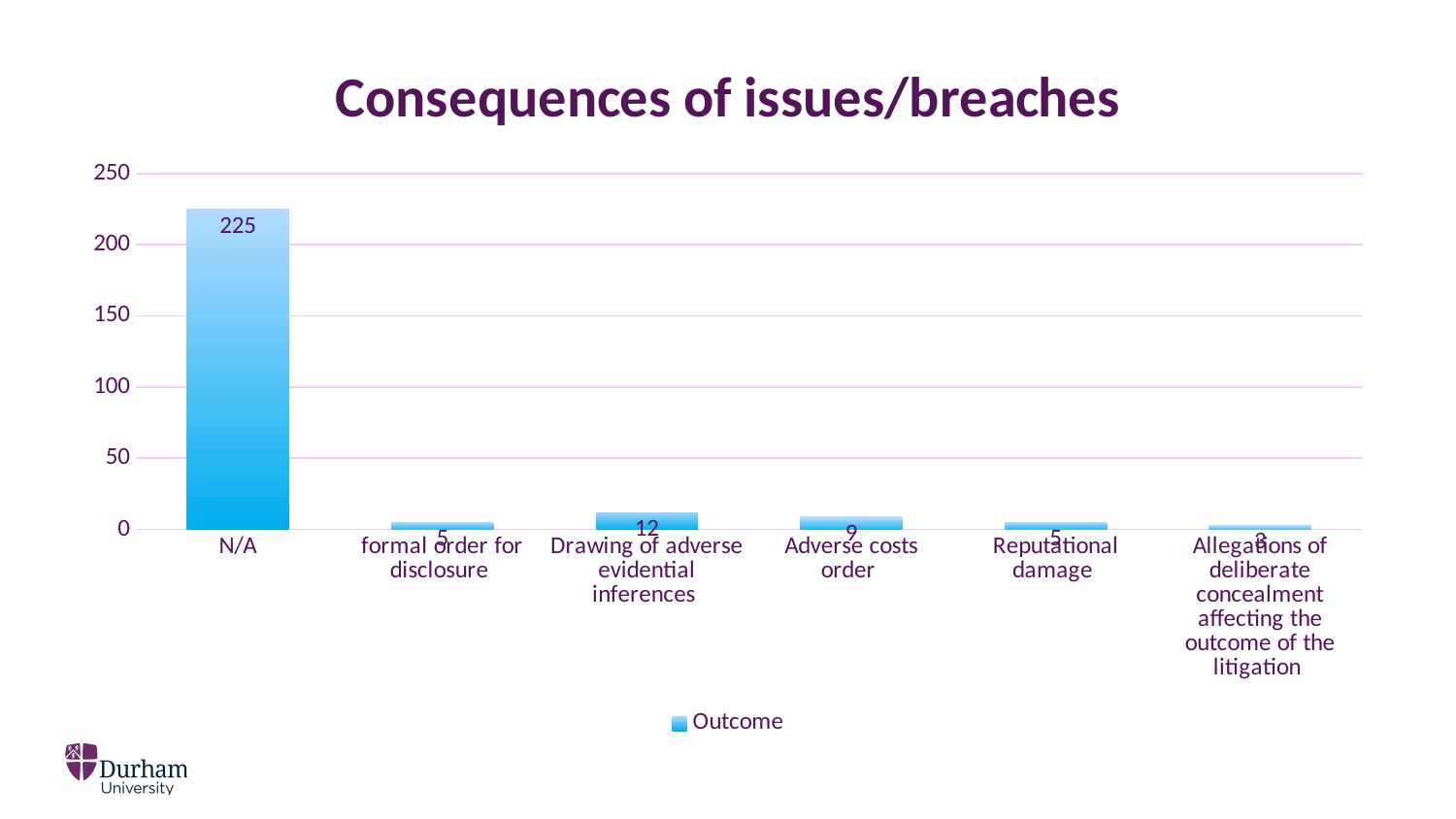
What is the value for N/A? 225 Which is larger, the value for Drawing of adverse evidential inferences or the value for Adverse costs order? Drawing of adverse evidential inferences What is the difference between the values for N/A and Drawing of adverse evidential inferences? 213 Is the value for N/A greater or less than 200? greater How many series does the legend list? 1 What is the difference between the values for Drawing of adverse evidential inferences and Adverse costs order? 3 What kind of chart is shown on the slide? bar chart How many categories are shown on the x axis? 6 What is the value for Drawing of adverse evidential inferences? 12 What is the value for Reputational damage? 5 Which category has the highest value? N/A What is the value for Adverse costs order? 9